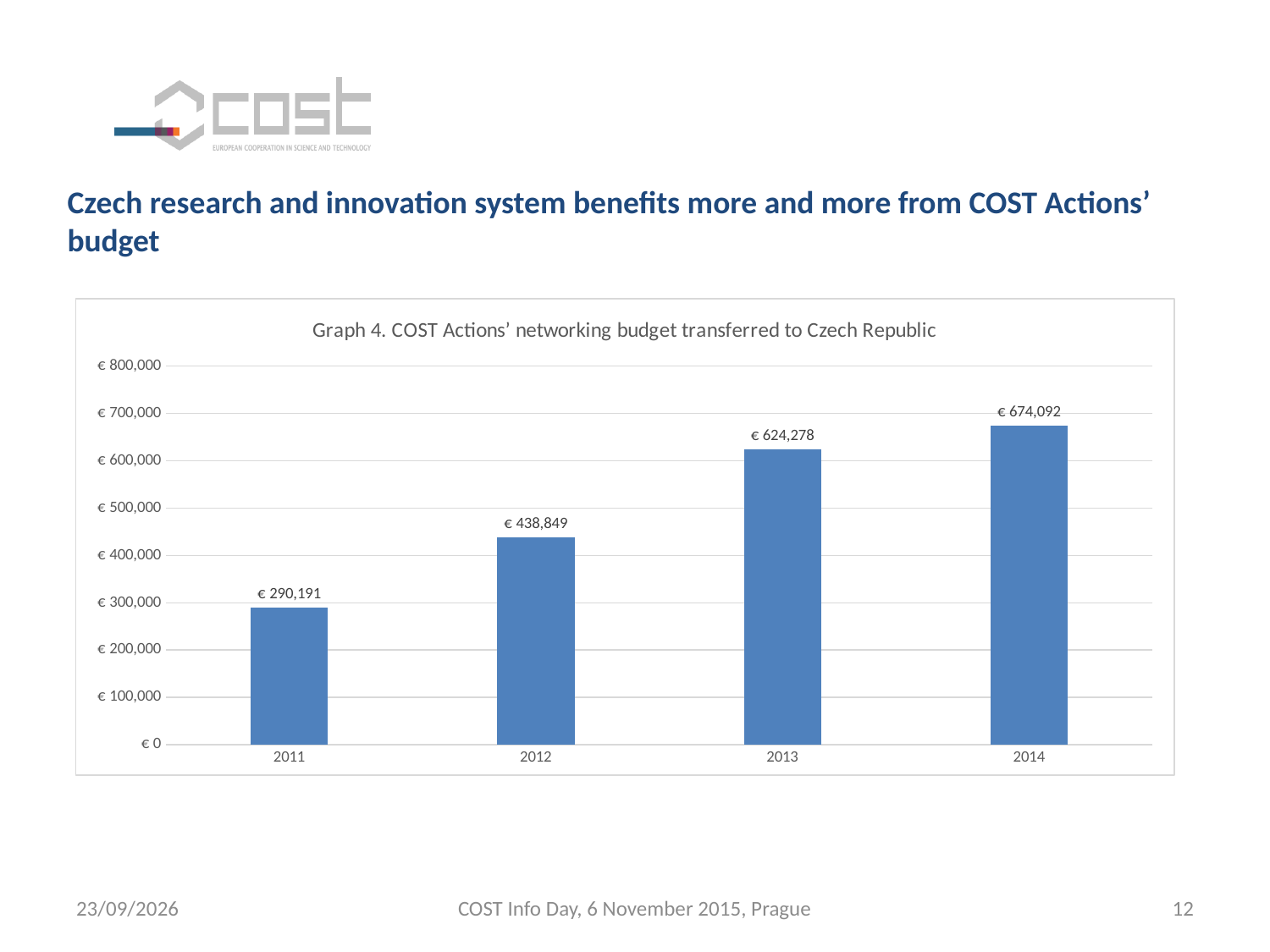
Is the value for 2012 greater or less than € 400,000? greater What is the value for 2014? € 674,092 What kind of chart is this? bar chart What is the difference between the values for 2012 and 2011? € 148,658 What is the value for 2011? € 290,191 Do the values rise or fall from 2011 to 2014? rise Which year has the lowest value? 2011 Which is larger, the value for 2012 or the value for 2013? 2013 What is the difference between the values for 2014 and 2013? € 49,814 Which year has the highest value? 2014 How many years are shown on the x axis? 4 What is the value for 2013? € 624,278